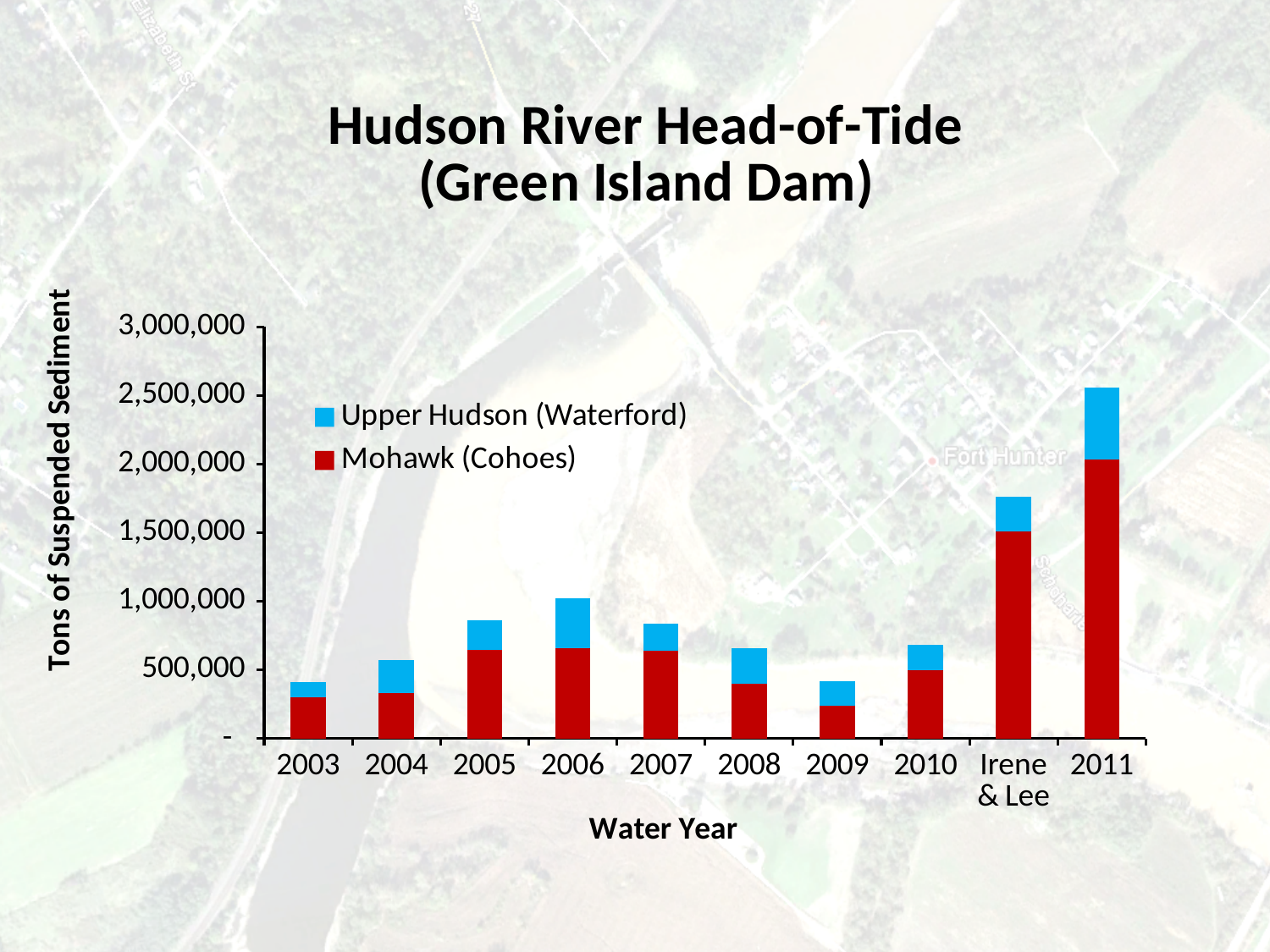
How many series does the legend list? 2 What is the title of the chart? Hudson River Head-of-Tide (Green Island Dam) Is the total value for 2005 greater or less than 1,000,000? less Is the Mohawk (Cohoes) value for 2008 greater or less than 500,000? less Which category has the highest total tons of suspended sediment? 2011 How many categories are shown on the x axis? 10 Is the total value for Irene & Lee greater or less than 1,500,000? greater What kind of chart is shown on the slide? stacked bar chart Which has the larger total, Irene & Lee or 2010? Irene & Lee Which has the larger total, 2006 or 2005? 2006